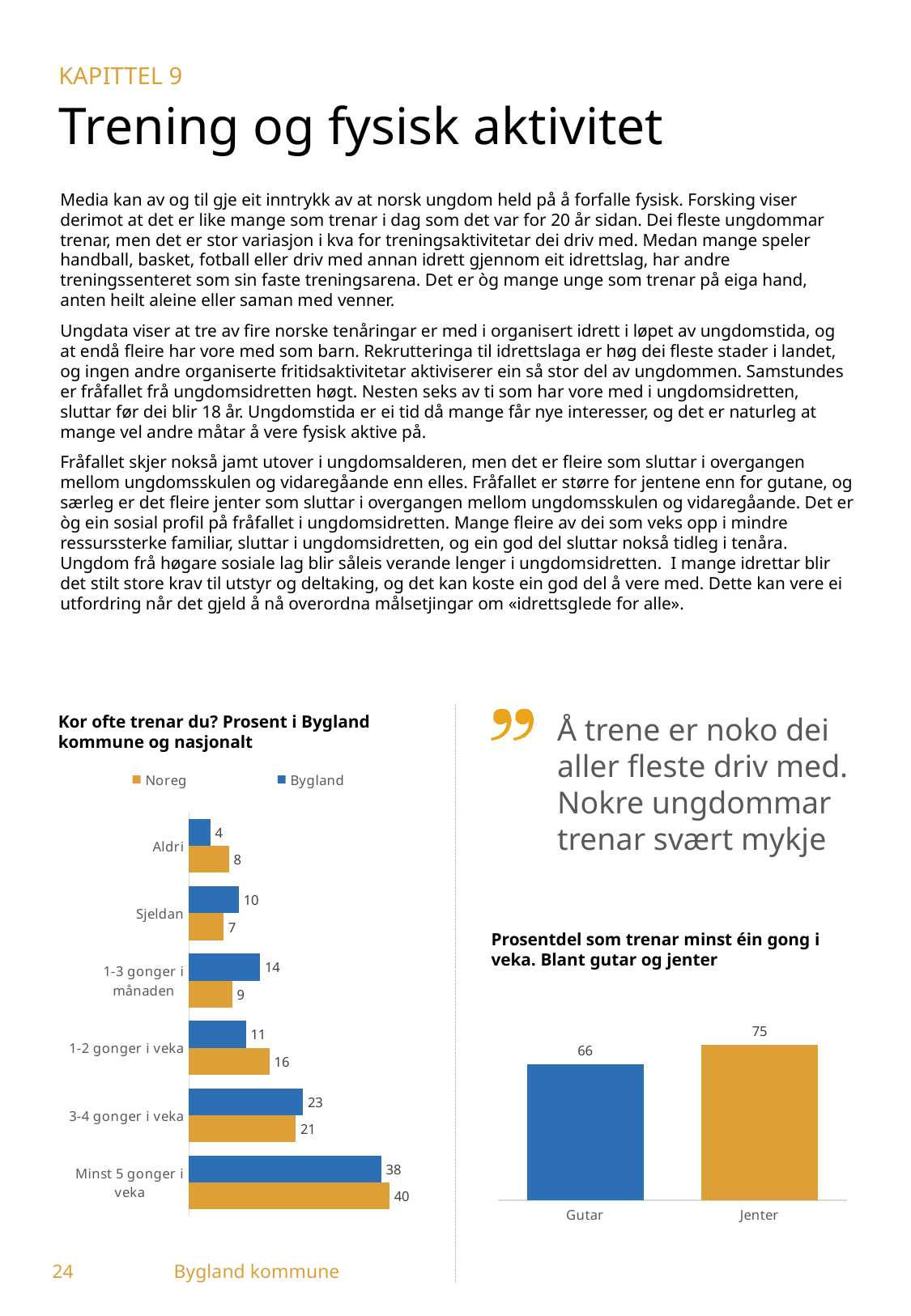
In the chart 'Kor ofte trenar du? Prosent i Bygland kommune og nasjonalt', which category has the lowest Bygland value? Aldri In the chart 'Prosentdel som trenar minst éin gong i veka. Blant gutar og jenter', what is the difference between Jenter and Gutar? 9 In the chart 'Prosentdel som trenar minst éin gong i veka. Blant gutar og jenter', what is the value for Jenter? 75 How many series does the legend list in the chart 'Kor ofte trenar du? Prosent i Bygland kommune og nasjonalt'? 2 In the chart 'Kor ofte trenar du? Prosent i Bygland kommune og nasjonalt', which category has the highest Noreg value? Minst 5 gonger i veka In the chart 'Kor ofte trenar du? Prosent i Bygland kommune og nasjonalt', what colour are the Noreg bars? Orange What kind of chart is 'Kor ofte trenar du? Prosent i Bygland kommune og nasjonalt'? Bar chart In the chart 'Kor ofte trenar du? Prosent i Bygland kommune og nasjonalt', which is larger for '3-4 gonger i veka', Noreg or Bygland? Bygland How many categories are shown in the chart 'Kor ofte trenar du? Prosent i Bygland kommune og nasjonalt'? 6 In the chart 'Kor ofte trenar du? Prosent i Bygland kommune og nasjonalt', what is the Noreg value for 'Aldri'? 8 In the chart 'Kor ofte trenar du? Prosent i Bygland kommune og nasjonalt', what is the difference between the Noreg and Bygland values for '1-2 gonger i veka'? 5 In the chart 'Kor ofte trenar du? Prosent i Bygland kommune og nasjonalt', what is the Bygland value for 'Minst 5 gonger i veka'? 38